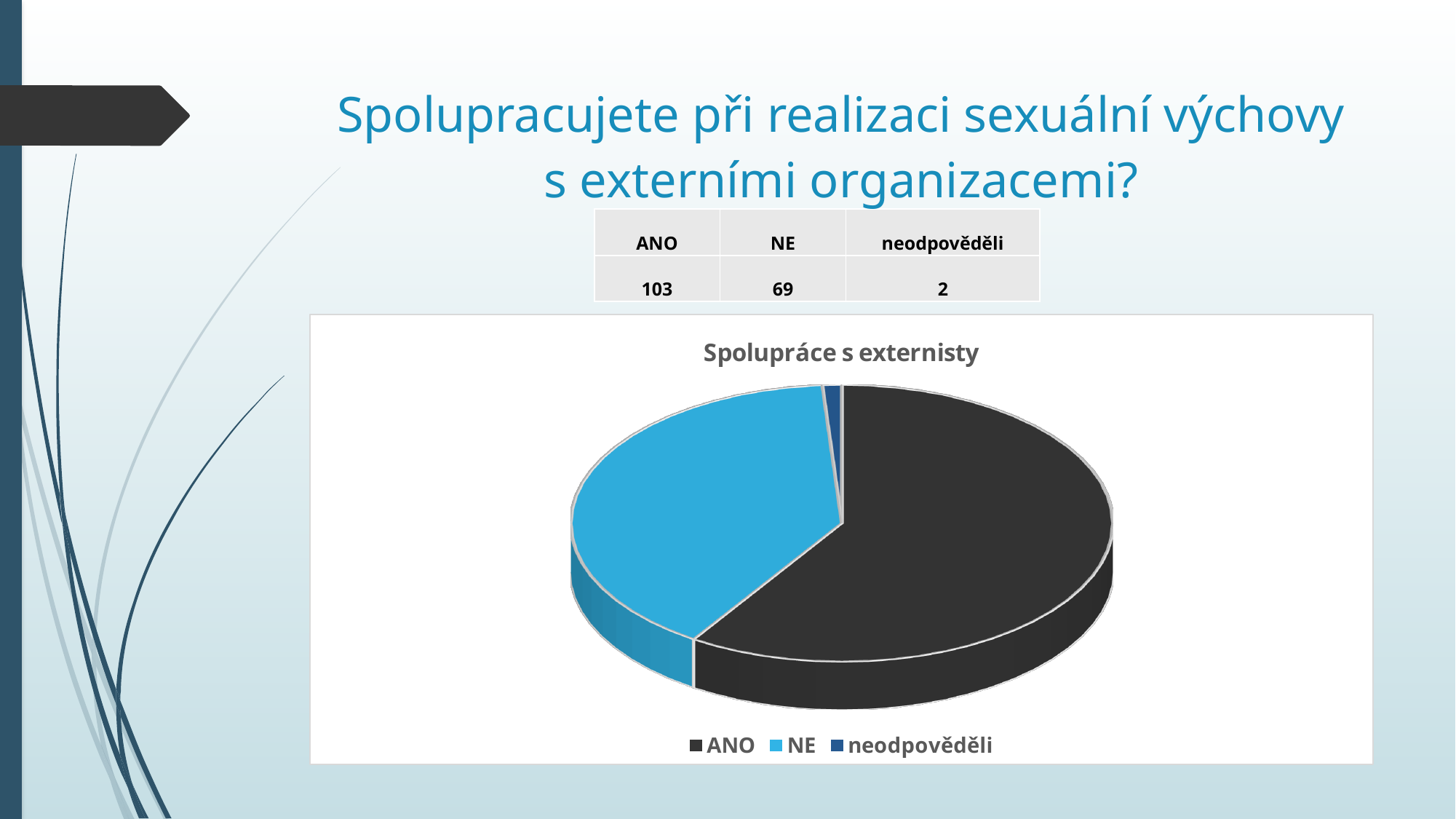
What is the value for NE? 69 How many categories does the pie chart have? 3 What type of chart is shown on the slide? pie chart What is the title of the chart? Spolupráce s externisty What is the value for ANO? 103 Which category has the smallest slice of the pie? neodpověděli What is the difference between the values for ANO and NE? 34 Which colour represents NE in the legend? light blue Which is larger, ANO or NE? ANO What is the total of all three categories? 174 Which category has the largest slice of the pie? ANO What is the value for neodpověděli? 2